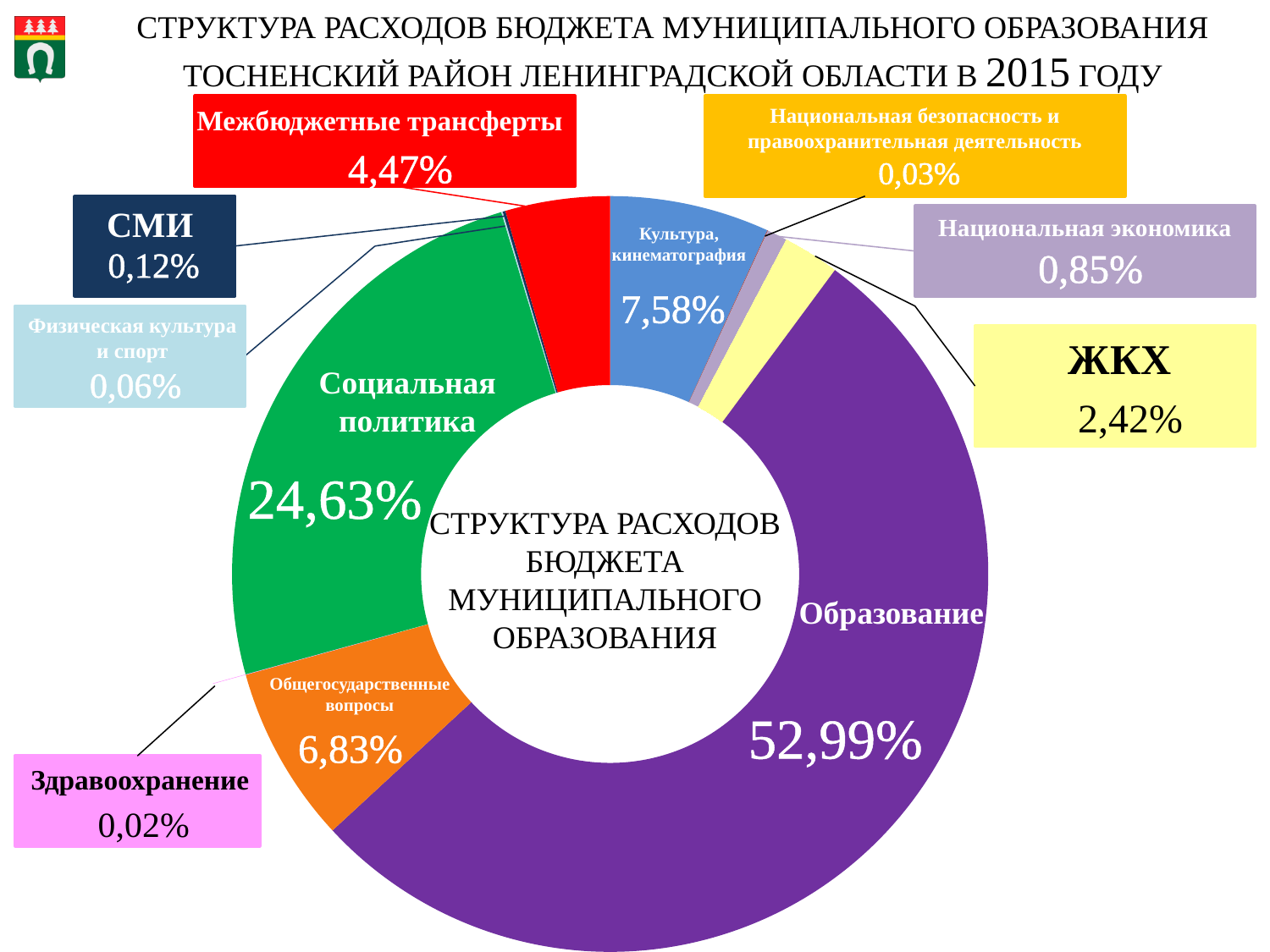
What type of chart is shown on the slide? Pie (doughnut) chart What share of budget expenditure goes to Социальная политика? 24,63% Which category has the largest share of budget expenditure? Образование Which category has the smallest share of budget expenditure? Здравоохранение How many expenditure categories are shown in the chart? 11 What is the difference in percentage points between Образование and Социальная политика? 28,36 What share of budget expenditure goes to Образование? 52,99% What percentage is shown for Культура, кинематография? 7,58% What percentage is shown for ЖКХ? 2,42% Which has a larger share: Общегосударственные вопросы or Межбюджетные трансферты? Общегосударственные вопросы What percentage is shown for Здравоохранение? 0,02% What colour is the Образование slice? Purple